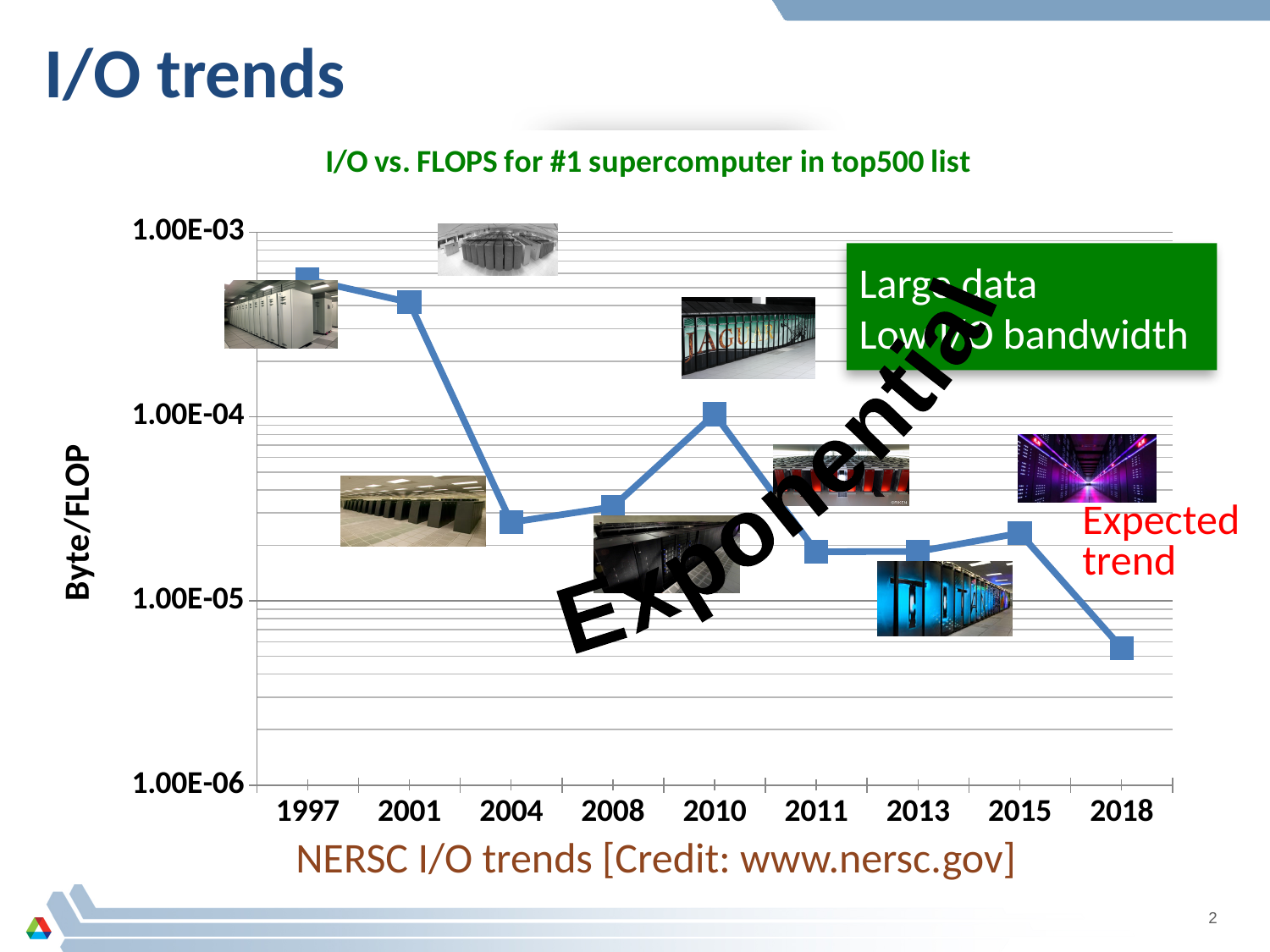
Which year has the highest Byte/FLOP value? 1997 How many years are plotted on the x axis? 9 Is the Byte/FLOP value for 2018 greater or less than 1.00E-05? less What is the title of the chart? I/O vs. FLOPS for #1 supercomputer in top500 list Overall, does the Byte/FLOP value rise or fall from 1997 to 2018? fall Is the Byte/FLOP value for 1997 greater or less than 1.00E-04? greater Is the Byte/FLOP value for 2013 greater or less than 1.00E-04? less What kind of chart is shown on the slide? line chart Which year has the larger Byte/FLOP value, 2010 or 2011? 2010 Which year has the larger Byte/FLOP value, 2001 or 2004? 2001 Which year has the lowest Byte/FLOP value? 2018 What is the label of the y axis? Byte/FLOP